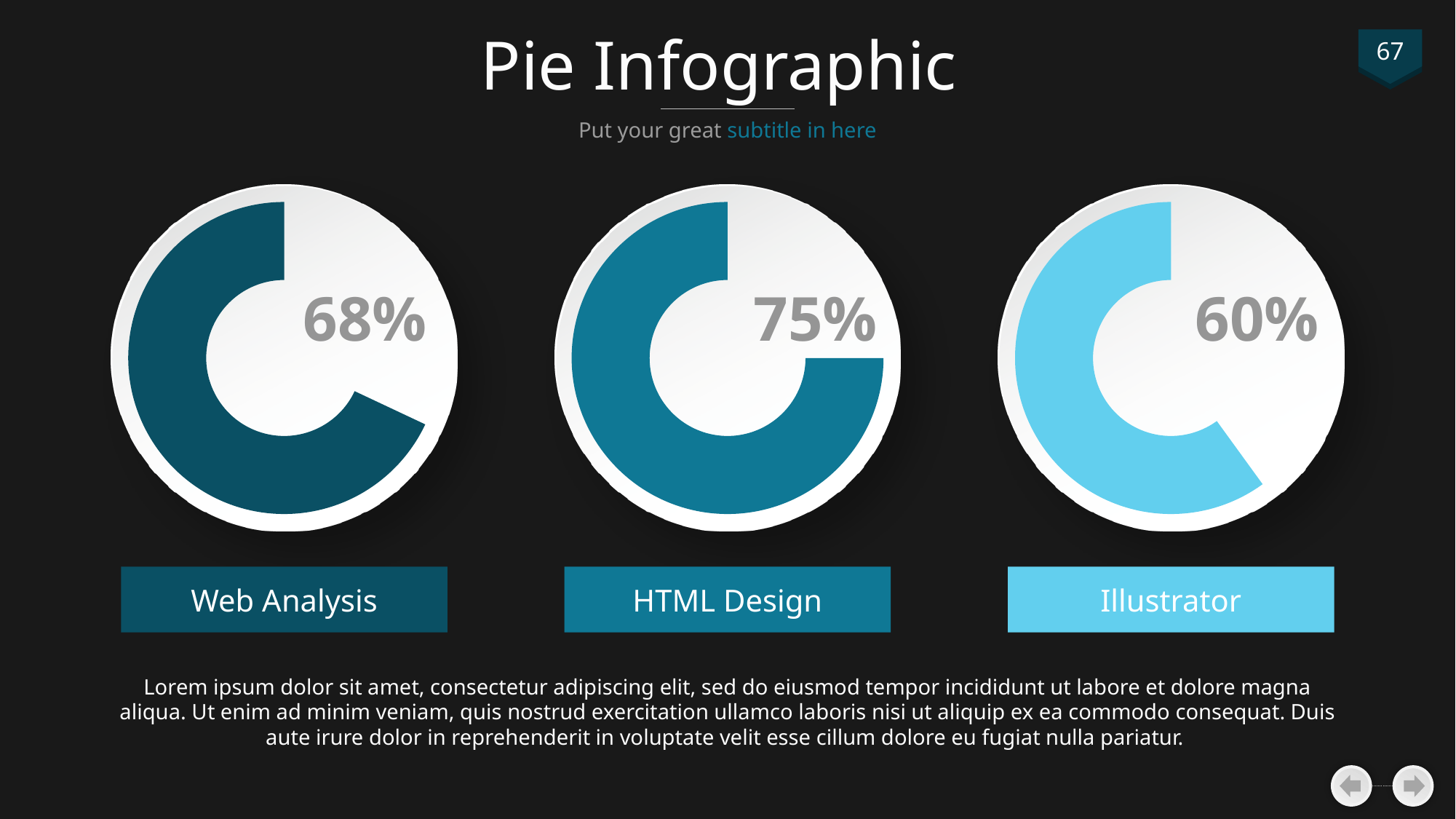
What is the difference between the HTML Design percentage and the Web Analysis percentage? 7% Which of the three charts shows the highest percentage? HTML Design What kind of chart is used to show the percentages on this slide? Doughnut chart What percentage is shown for Web Analysis? 68% Which of the three charts shows the lowest percentage? Illustrator What is the title of the slide? Pie Infographic What percentage is shown for HTML Design? 75% How many pie charts are shown on the slide? 3 What percentage is shown for Illustrator? 60% Which is larger, the Web Analysis percentage or the Illustrator percentage? Web Analysis What is the difference between the Web Analysis percentage and the Illustrator percentage? 8% What colour is the filled portion of the Illustrator chart? Light blue